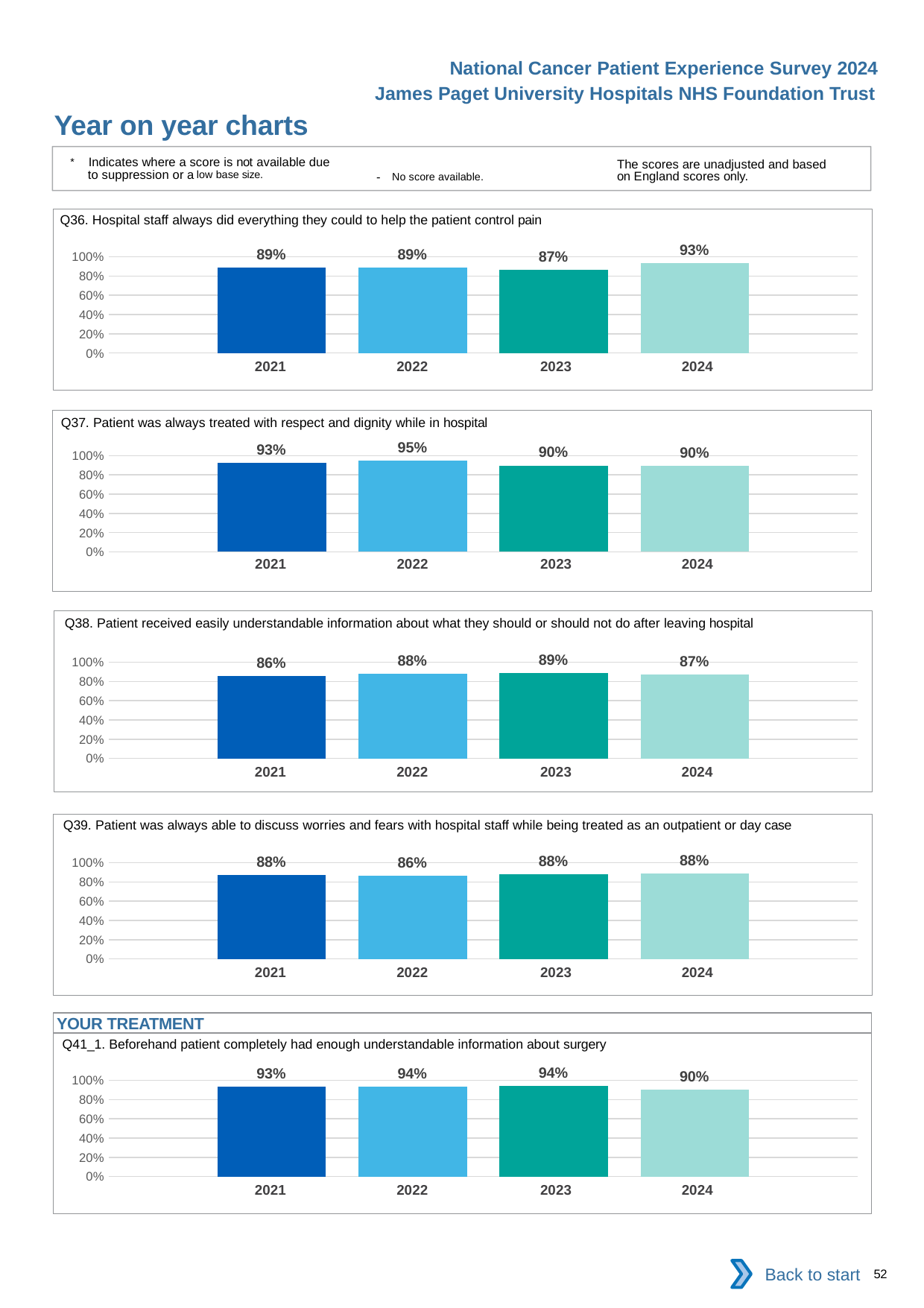
In the Q36 chart, which is larger, the value for 2023 or the value for 2024? 2024 In the Q41_1 chart (beforehand patient completely had enough understandable information about surgery), what is the difference between the 2023 value and the 2024 value? 4% In the Q36 chart (hospital staff always did everything they could to help the patient control pain), what is the value for 2024? 93% Which section heading appears above the Q41_1 chart? YOUR TREATMENT In the Q41_1 chart, what is the value for 2021? 93% In the Q39 chart (patient was always able to discuss worries and fears with hospital staff while being treated as an outpatient or day case), what is the value for 2022? 86% In the Q38 chart (patient received easily understandable information about what they should or should not do after leaving hospital), which year has the lowest value? 2021 In the Q37 chart, what is the difference between the 2021 value and the 2023 value? 3% What kind of chart is the Q41_1 chart? Bar chart In the Q37 chart (patient was always treated with respect and dignity while in hospital), which year has the highest value? 2022 How many years are shown in the Q38 chart? 4 In the Q37 chart, is the value for 2024 greater or less than 80%? greater